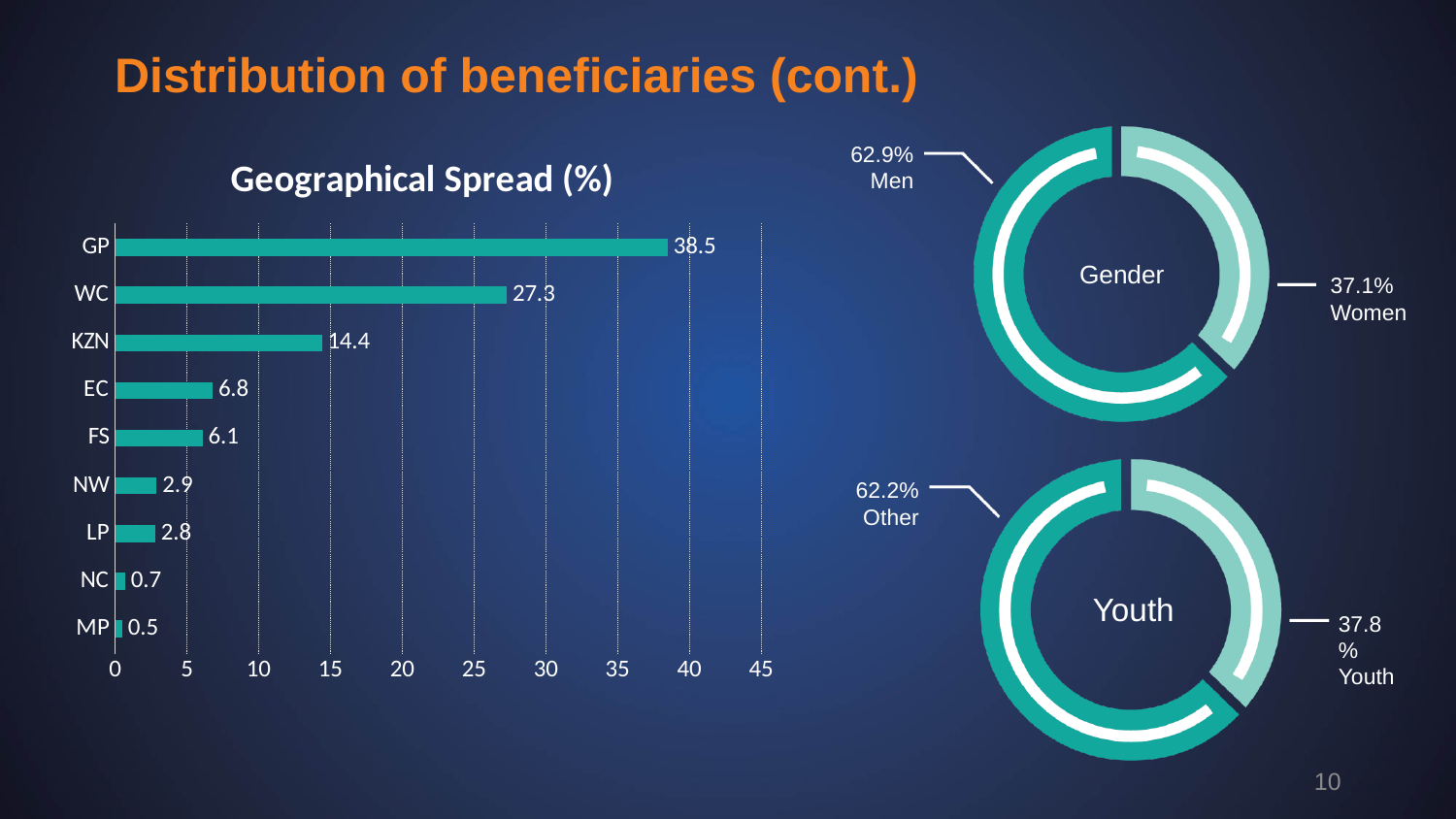
In the Geographical Spread (%) chart, which province has the highest value? GP In the Youth chart, which is larger, the Other share or the Youth share? Other In the Geographical Spread (%) chart, what is the value for GP? 38.5 In the Gender chart, what share is Women? 37.1% In the Geographical Spread (%) chart, which is larger, the value for EC or the value for FS? EC What kind of chart is the Geographical Spread (%) chart? Bar chart In the Geographical Spread (%) chart, which province has the lowest value? MP In the Geographical Spread (%) chart, what is the difference between the values for GP and WC? 11.2 How many provinces are shown in the Geographical Spread (%) chart? 9 In the Geographical Spread (%) chart, what is the value for KZN? 14.4 In the Gender chart, what share is Men? 62.9% In the Youth chart, what share is Youth? 37.8%